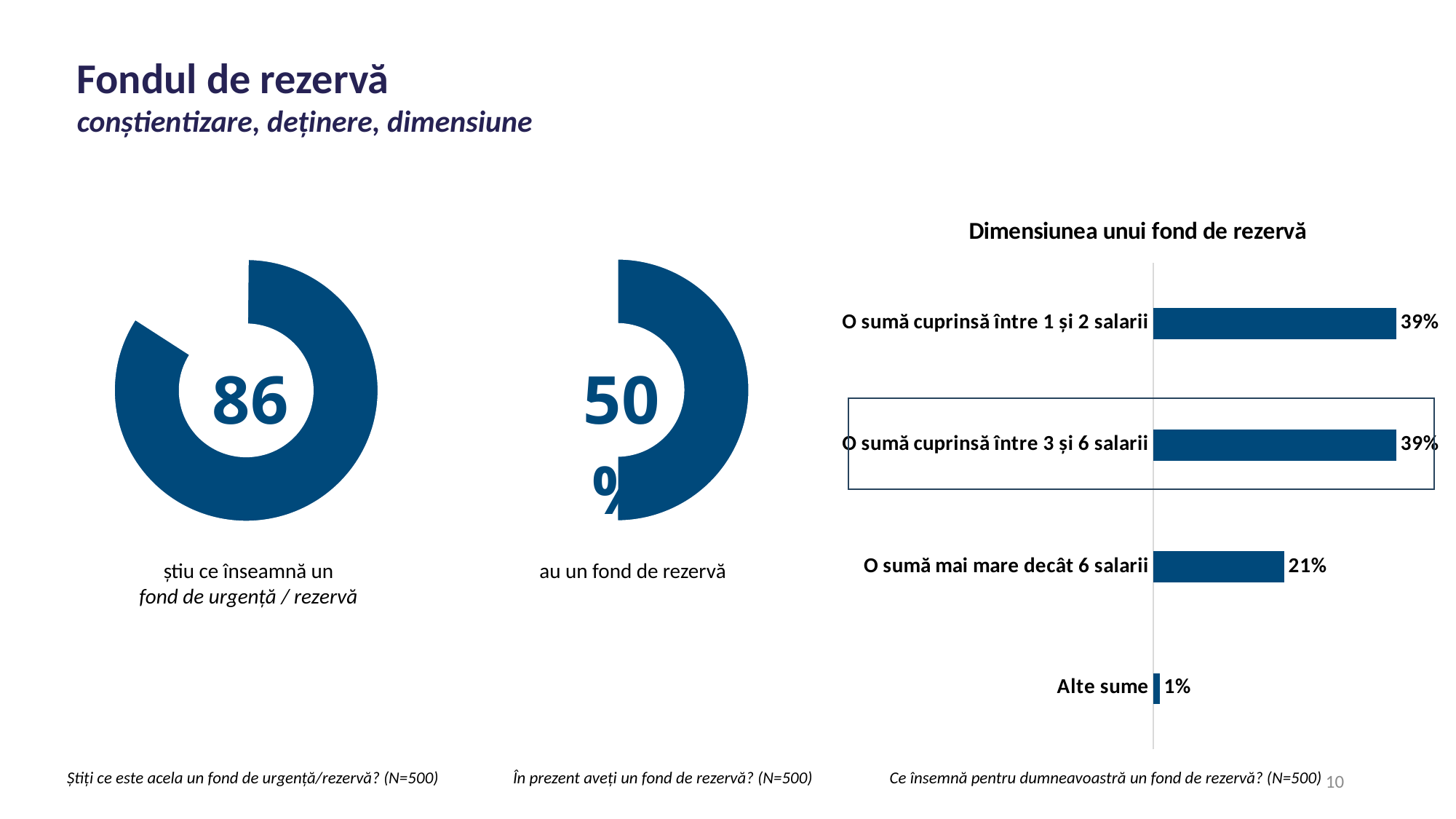
In the chart titled "Dimensiunea unui fond de rezervă", what is the value for "O sumă cuprinsă între 1 și 2 salarii"? 39% In the chart titled "Dimensiunea unui fond de rezervă", what is the total of all four category values? 100% What kind of chart is the chart titled "Dimensiunea unui fond de rezervă"? Bar chart In the chart titled "Dimensiunea unui fond de rezervă", which is larger: the value for "O sumă cuprinsă între 3 și 6 salarii" or the value for "O sumă mai mare decât 6 salarii"? O sumă cuprinsă între 3 și 6 salarii In the chart titled "Dimensiunea unui fond de rezervă", what is the difference between the values for "O sumă cuprinsă între 3 și 6 salarii" and "O sumă mai mare decât 6 salarii"? 18 percentage points What value is shown in the centre of the middle donut chart, labelled "au un fond de rezervă"? 50% In the chart titled "Dimensiunea unui fond de rezervă", what is the value for "O sumă mai mare decât 6 salarii"? 21% In the chart titled "Dimensiunea unui fond de rezervă", which category has the lowest value? Alte sume How many categories are shown in the chart titled "Dimensiunea unui fond de rezervă"? 4 In the chart titled "Dimensiunea unui fond de rezervă", what is the value for "Alte sume"? 1% What is the title of the bar chart on the right side of the slide? Dimensiunea unui fond de rezervă What number is shown in the centre of the left donut chart, labelled "știu ce înseamnă un fond de urgență / rezervă"? 86